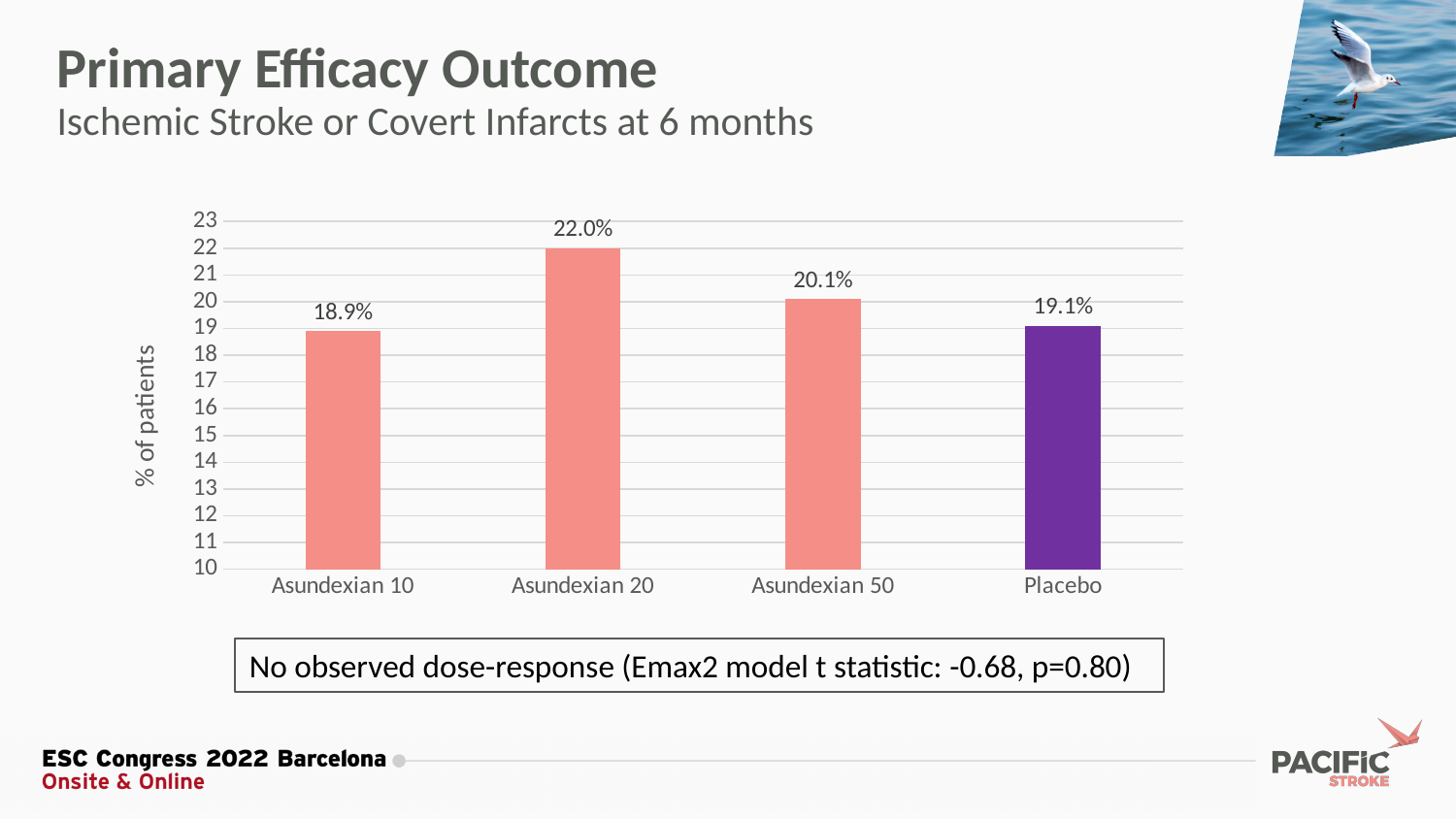
Which category has the highest value? Asundexian 20 What is the value for Asundexian 10? 18.9% Which is larger, the value for Asundexian 50 or the value for Placebo? Asundexian 50 What is the label of the y axis? % of patients What is the value for Asundexian 20? 22.0% What is the value for Asundexian 50? 20.1% How many categories are shown on the x axis? 4 What is the difference between the values for Asundexian 20 and Placebo? 2.9% What is the value for Placebo? 19.1% Which category has the lowest value? Asundexian 10 Is the value for Asundexian 20 greater or less than 21? greater What kind of chart is shown on the slide? bar chart